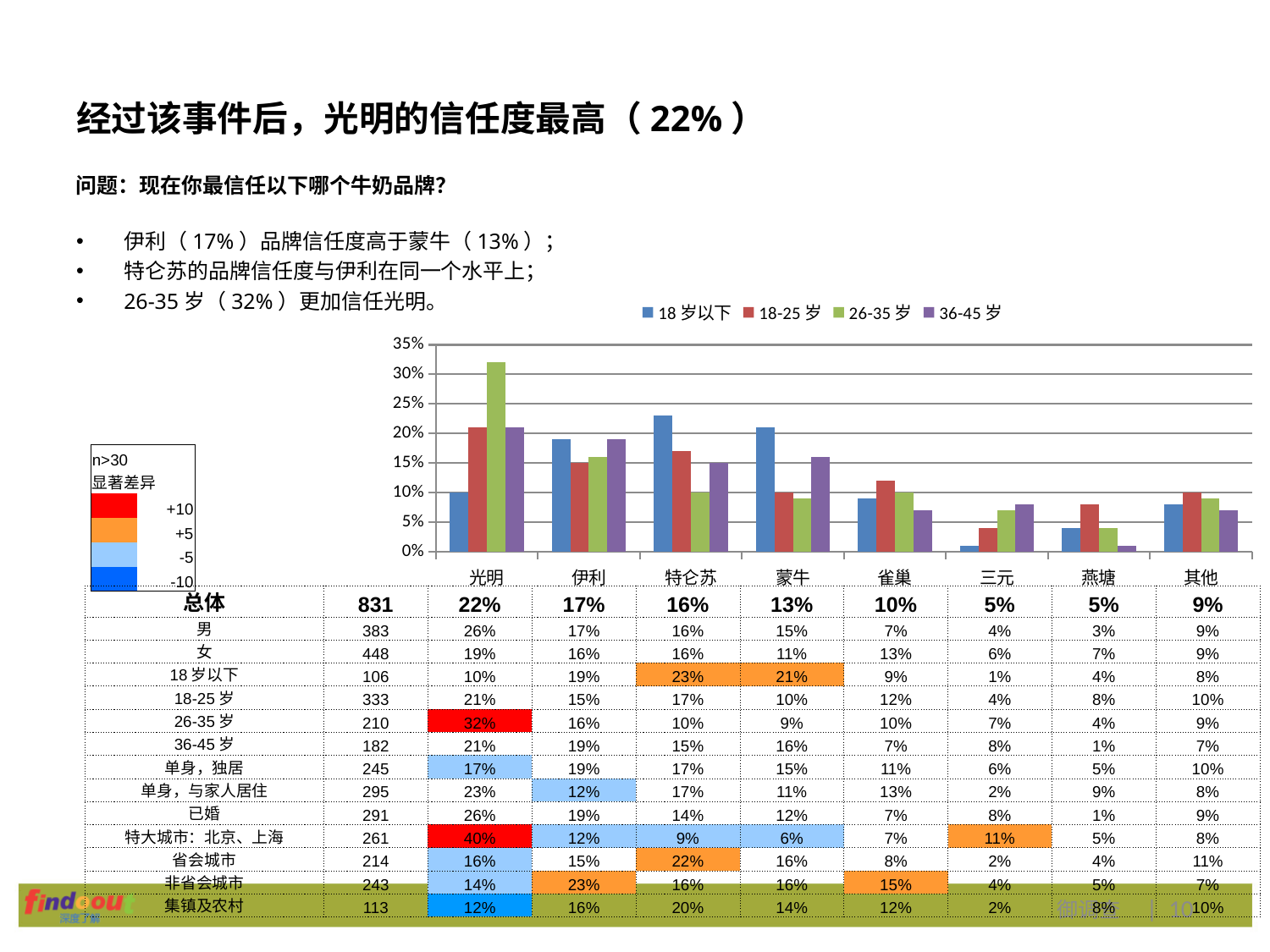
Is the value for 特仑苏 in the 18 岁以下 series greater or less than 20%? greater Which series is listed first in the chart legend? 18 岁以下 What is the value for 雀巢 in the 18-25 岁 series? 12% What is the difference between the 26-35 岁 value and the 18 岁以下 value for 光明? 22% Which brand has the lowest bar in the 18 岁以下 series? 三元 Which brand has the highest bar in the 26-35 岁 series? 光明 What kind of chart is shown on the slide? bar chart What is the value for 光明 in the 26-35 岁 series? 32% How many brand categories are plotted along the x axis of the chart? 8 For 蒙牛, which is larger: the 18 岁以下 value or the 18-25 岁 value? 18 岁以下 How many series does the chart legend list? 4 Is the value for 燕塘 in the 36-45 岁 series greater or less than 5%? less